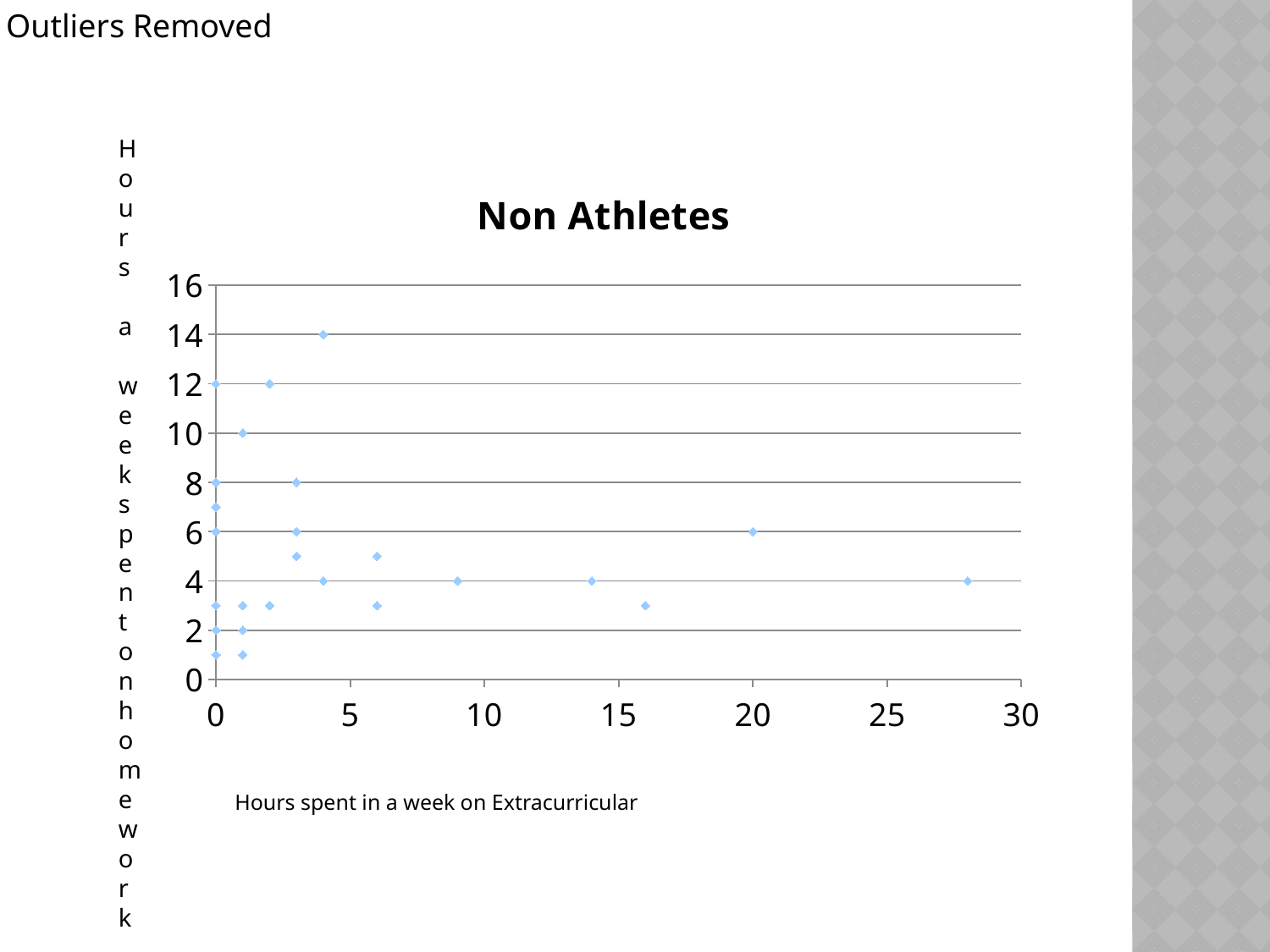
Is the lowest homework hours value plotted greater or less than 2? less What is the difference in homework hours between the point at 20 extracurricular hours and the rightmost point? 2 What kind of chart is shown on the slide? scatter chart What is the homework hours value for the point at 20 extracurricular hours? 6 What is the label of the horizontal axis of the chart? Hours spent in a week on Extracurricular What is the title of the chart? Non Athletes Is the extracurricular hours value of the rightmost point greater or less than 25? greater Is the extracurricular hours value of the highest plotted point greater or less than 5? less What is the maximum value shown on the horizontal axis? 30 What is the highest value of hours spent on homework plotted in the chart? 14 What is the homework hours value for the rightmost point in the chart? 4 Which has the higher homework hours value: the point at 20 extracurricular hours or the rightmost point? the point at 20 extracurricular hours